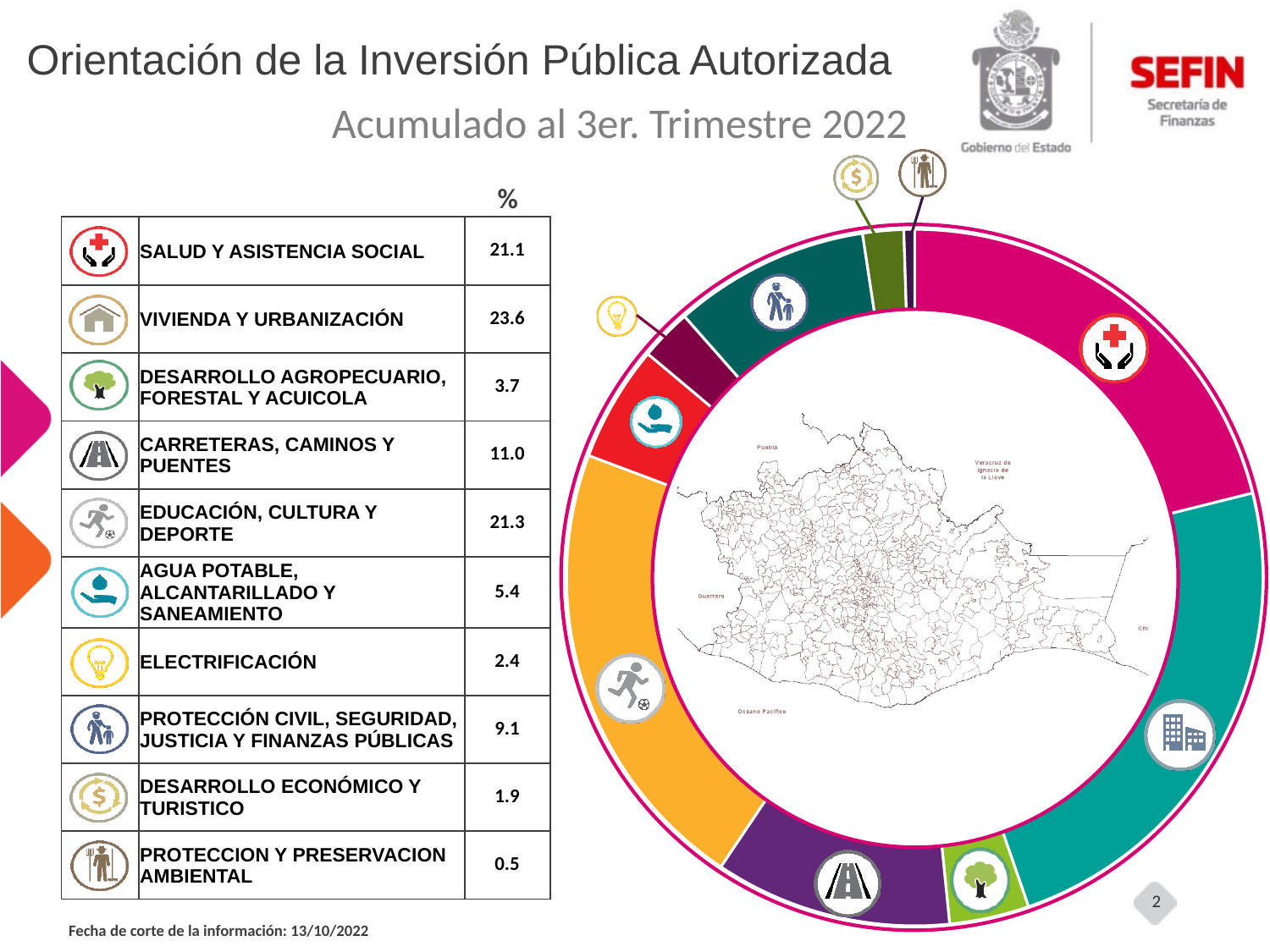
What kind of chart is used to show the distribution of the authorized public investment? Pie (donut) chart Which category has the largest share of the authorized public investment? VIVIENDA Y URBANIZACIÓN What percentage is shown for VIVIENDA Y URBANIZACIÓN? 23.6 Which has a larger share: CARRETERAS, CAMINOS Y PUENTES or PROTECCIÓN CIVIL, SEGURIDAD, JUSTICIA Y FINANZAS PÚBLICAS? CARRETERAS, CAMINOS Y PUENTES What is the title of the slide containing the chart? Orientación de la Inversión Pública Autorizada What is the combined percentage of ELECTRIFICACIÓN and DESARROLLO ECONÓMICO Y TURISTICO? 4.3 Which category has the smallest share of the authorized public investment? PROTECCION Y PRESERVACION AMBIENTAL What percentage is shown for AGUA POTABLE, ALCANTARILLADO Y SANEAMIENTO? 5.4 What is the difference in percentage points between VIVIENDA Y URBANIZACIÓN and SALUD Y ASISTENCIA SOCIAL? 2.5 What percentage of the authorized public investment goes to SALUD Y ASISTENCIA SOCIAL? 21.1 What percentage is shown for CARRETERAS, CAMINOS Y PUENTES? 11.0 How many investment categories are shown in the chart? 10